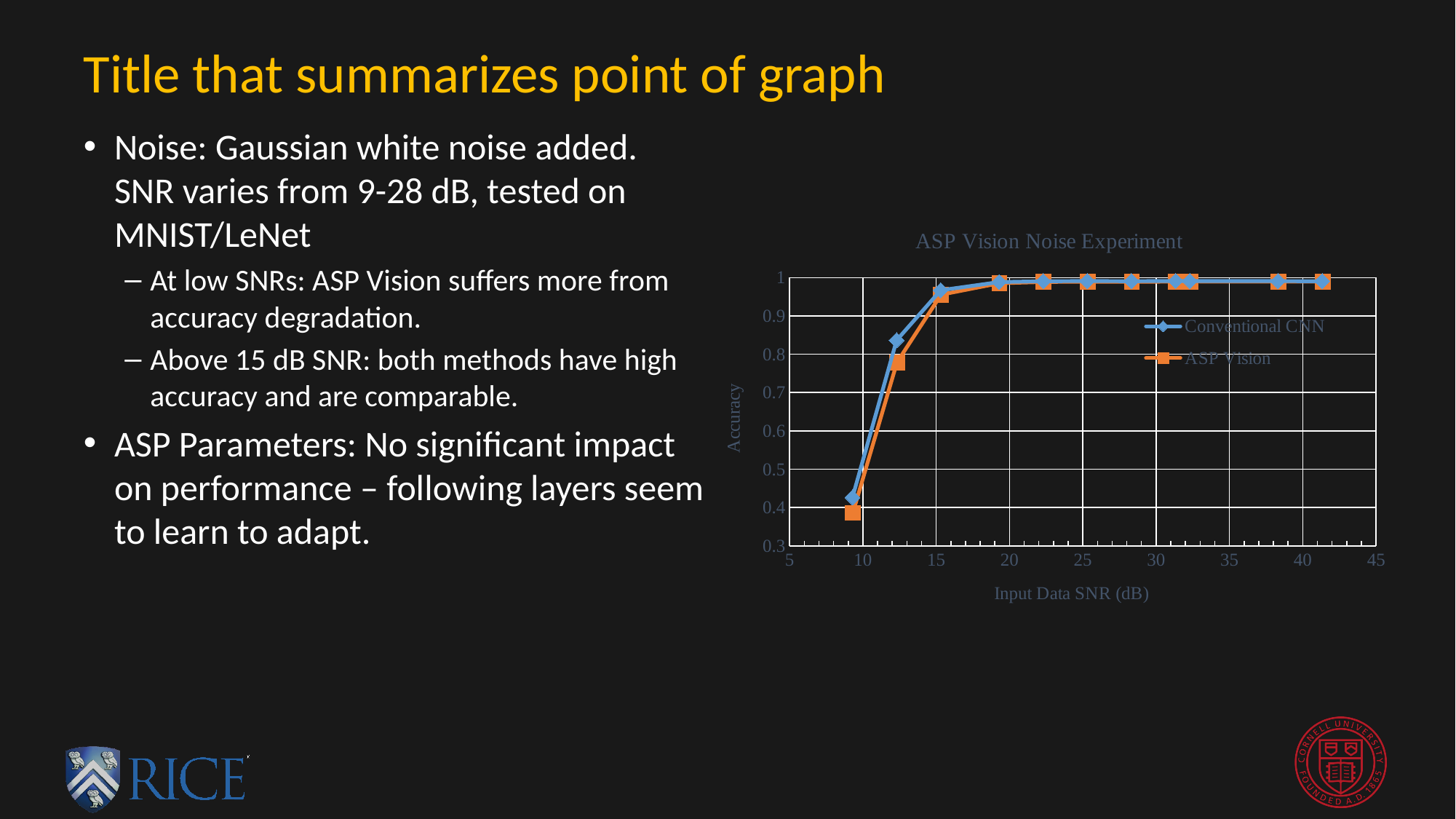
Which series has the lowest accuracy value anywhere on the chart? ASP Vision At the lowest SNR plotted, which series has the higher accuracy, Conventional CNN or ASP Vision? Conventional CNN At the second-lowest SNR plotted (around 12 dB), is the accuracy of ASP Vision greater or less than 0.7? greater At the lowest SNR plotted, is the accuracy of Conventional CNN greater or less than 0.5? less At an SNR of about 20 dB, is the accuracy of Conventional CNN greater or less than 0.9? greater What is the title of the chart? ASP Vision Noise Experiment How many series does the legend of the chart list? 2 What kind of chart is shown on the slide? Line chart What is the label of the x axis of the chart? Input Data SNR (dB) Does accuracy rise or fall as Input Data SNR increases along the x axis? Rise At the second-lowest SNR plotted (around 12 dB), which series has the higher accuracy, Conventional CNN or ASP Vision? Conventional CNN